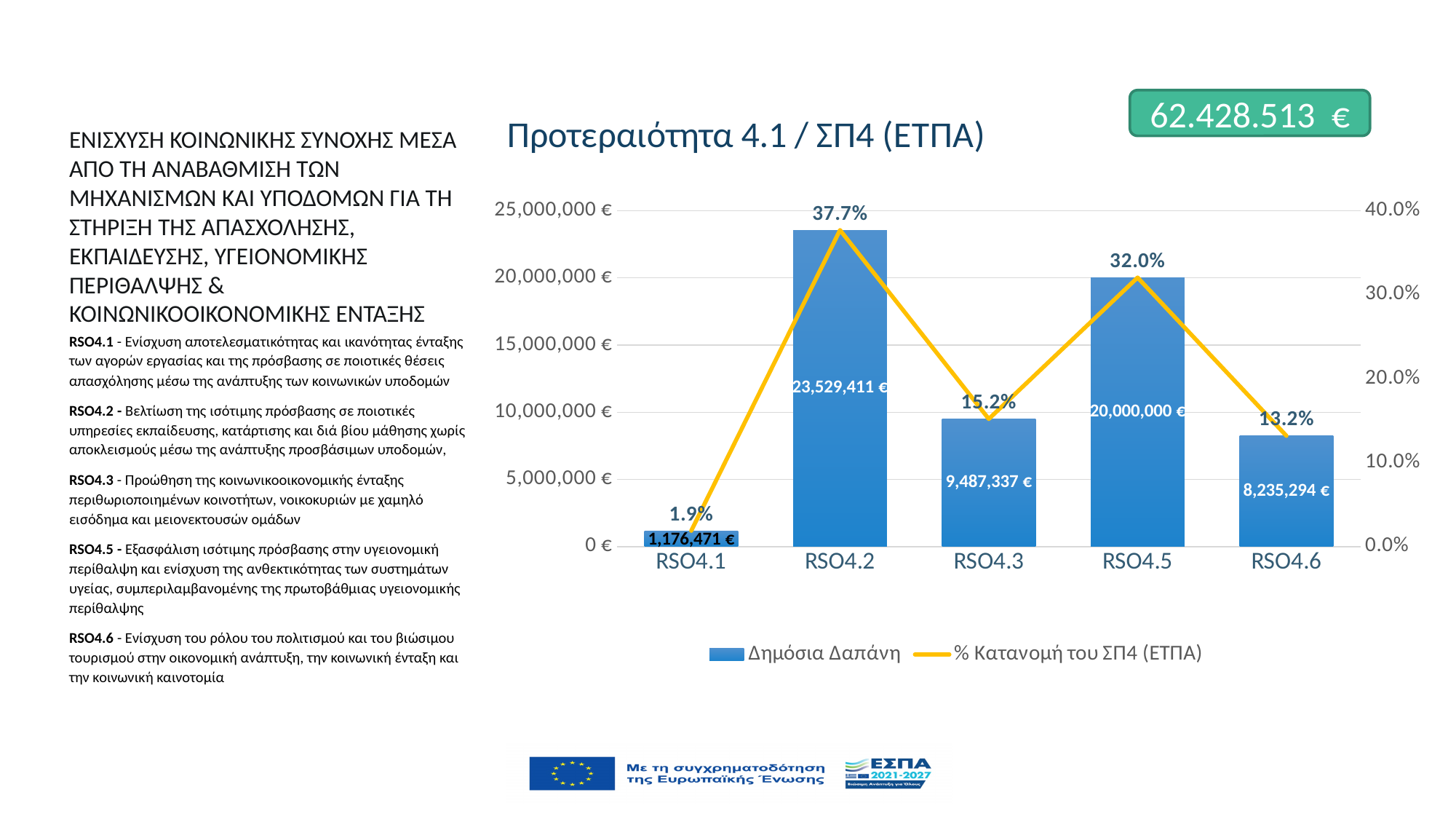
What is the title of the chart? Προτεραιότητα 4.1 / ΣΠ4 (ΕΤΠΑ) Which has a larger Δημόσια Δαπάνη, RSO4.3 or RSO4.6? RSO4.3 What is the Δημόσια Δαπάνη value for RSO4.2? 23,529,411 € What is the difference in Δημόσια Δαπάνη between RSO4.2 and RSO4.5? 3,529,411 € Which category has the highest Δημόσια Δαπάνη? RSO4.2 Which category has the lowest % Κατανομή του ΣΠ4 (ΕΤΠΑ)? RSO4.1 What is the Δημόσια Δαπάνη value for RSO4.6? 8,235,294 € What kind of chart is shown on the slide? Combined bar and line chart How many categories are shown on the x axis of the chart? 5 How many series does the chart legend list? 2 What percentage (% Κατανομή του ΣΠ4 (ΕΤΠΑ)) is shown for RSO4.5? 32.0% Is the Δημόσια Δαπάνη for RSO4.3 greater or less than 10,000,000 €? less